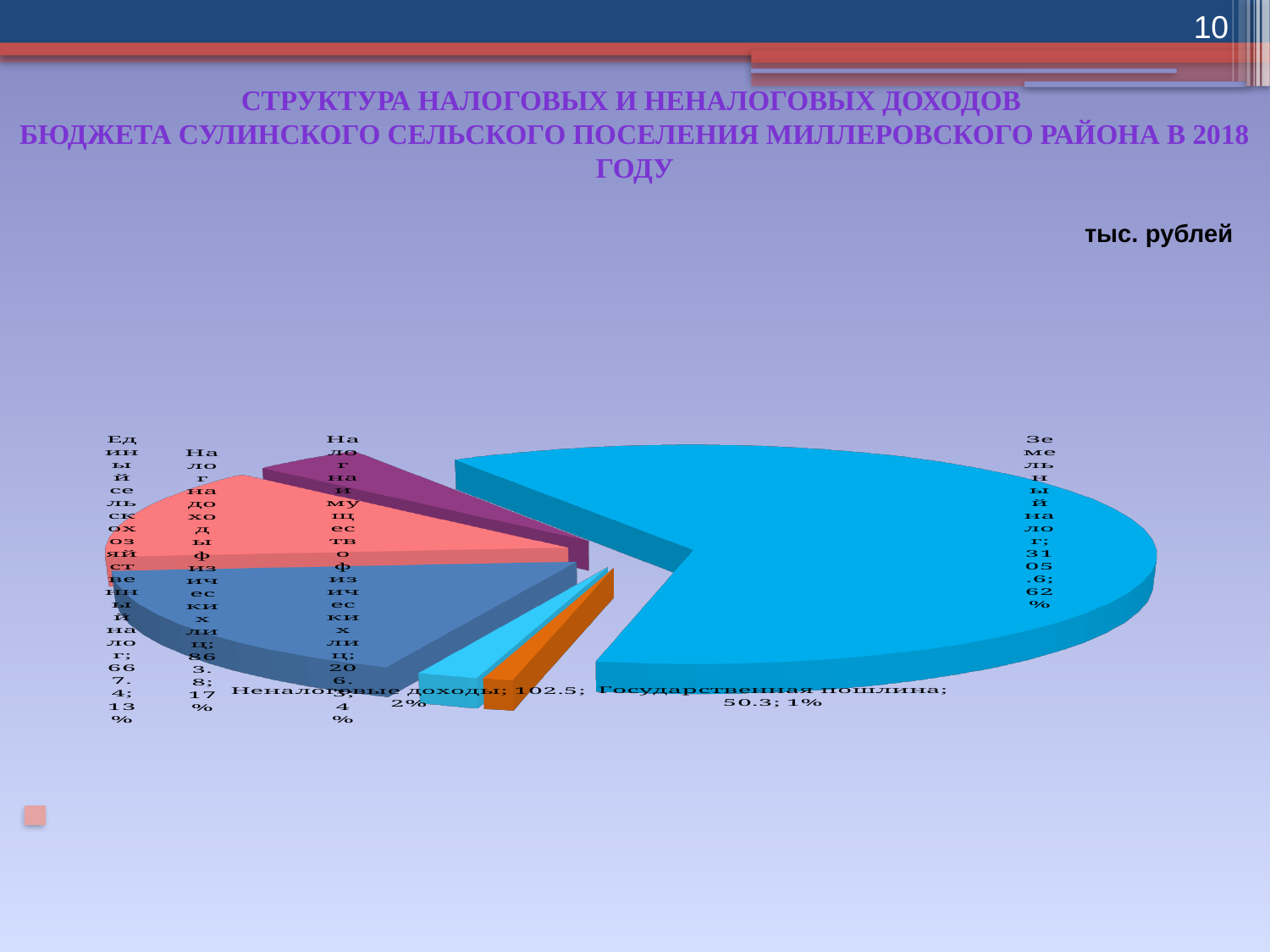
What is the value for Единый сельскохозяйственный налог? 667.4 What is the difference between the values for Налог на доходы физических лиц and Единый сельскохозяйственный налог? 196.4 What is the value for Государственная пошлина? 50.3 What share of the pie does Земельный налог represent? 62% How many slices does the pie chart have? 6 Which category has the smallest slice of the pie? Государственная пошлина What is the value for Земельный налог? 3105.6 What kind of chart is shown on the slide? pie chart Which category has the largest slice of the pie? Земельный налог In what units are the chart values given, according to the slide? тыс. рублей What share of the pie does Неналоговые доходы represent? 2% Which is larger: Налог на доходы физических лиц or Единый сельскохозяйственный налог? Налог на доходы физических лиц